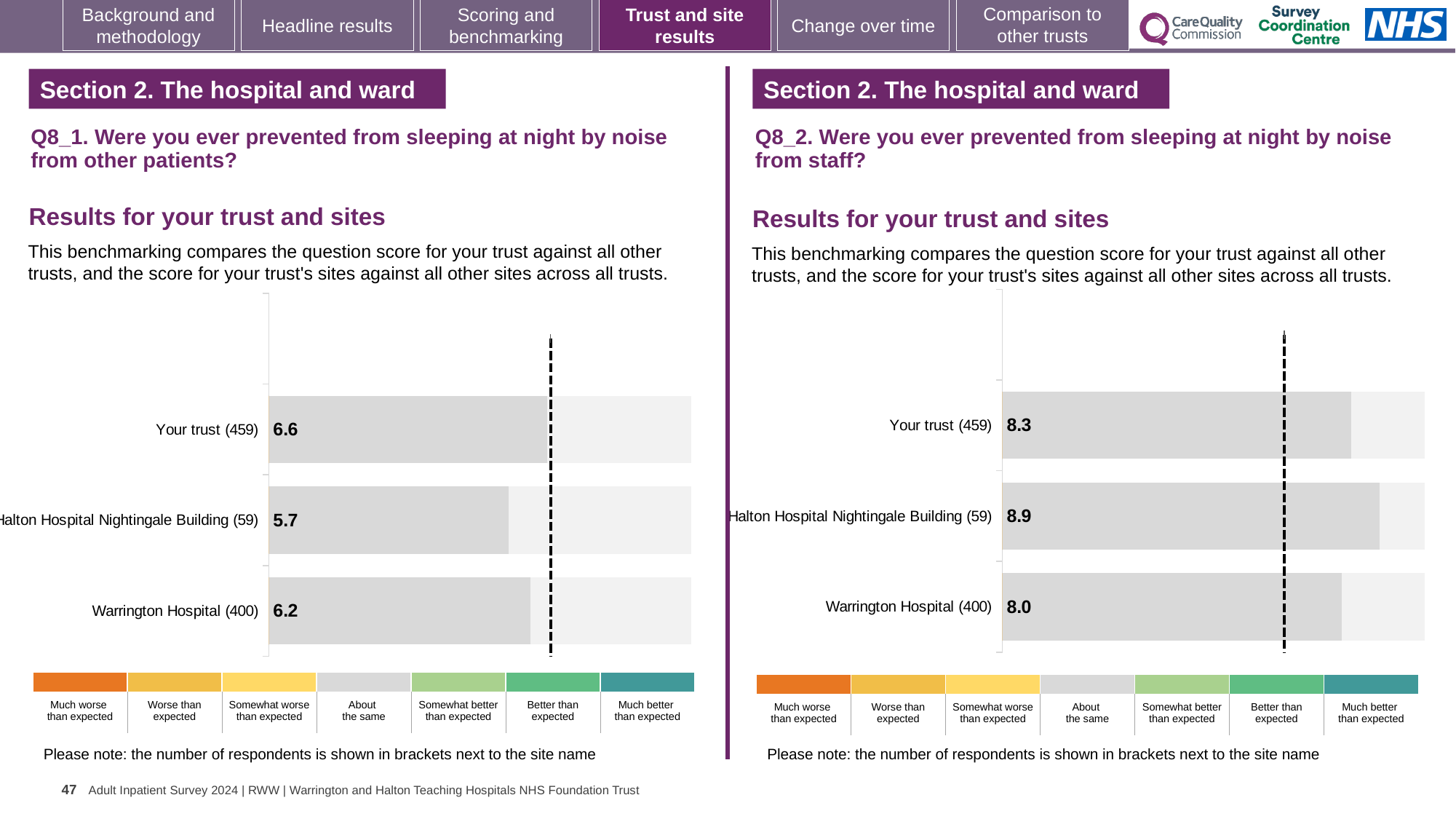
On the Q8_1 chart (noise from other patients), what is the score for Your trust (459)? 6.6 On the Q8_2 chart (noise from staff), what is the score for Halton Hospital Nightingale Building (59)? 8.9 On the Q8_2 chart (noise from staff), what is the score for Your trust (459)? 8.3 On the Q8_1 chart (noise from other patients), what is the score for Warrington Hospital (400)? 6.2 On the Q8_2 chart (noise from staff), which site or trust has the highest score? Halton Hospital Nightingale Building (59) On the Q8_1 chart (noise from other patients), what is the score for Halton Hospital Nightingale Building (59)? 5.7 On the Q8_1 chart (noise from other patients), what is the difference between the scores for Your trust (459) and Halton Hospital Nightingale Building (59)? 0.9 On the Q8_1 chart (noise from other patients), which site or trust has the lowest score? Halton Hospital Nightingale Building (59) On the Q8_2 chart (noise from staff), which has the larger score: Your trust (459) or Warrington Hospital (400)? Your trust (459) What kind of chart is used on the Q8_1 chart (noise from other patients)? Bar chart On the Q8_2 chart (noise from staff), what is the difference between the scores for Halton Hospital Nightingale Building (59) and Warrington Hospital (400)? 0.9 On the Q8_2 chart (noise from staff), what is the score for Warrington Hospital (400)? 8.0